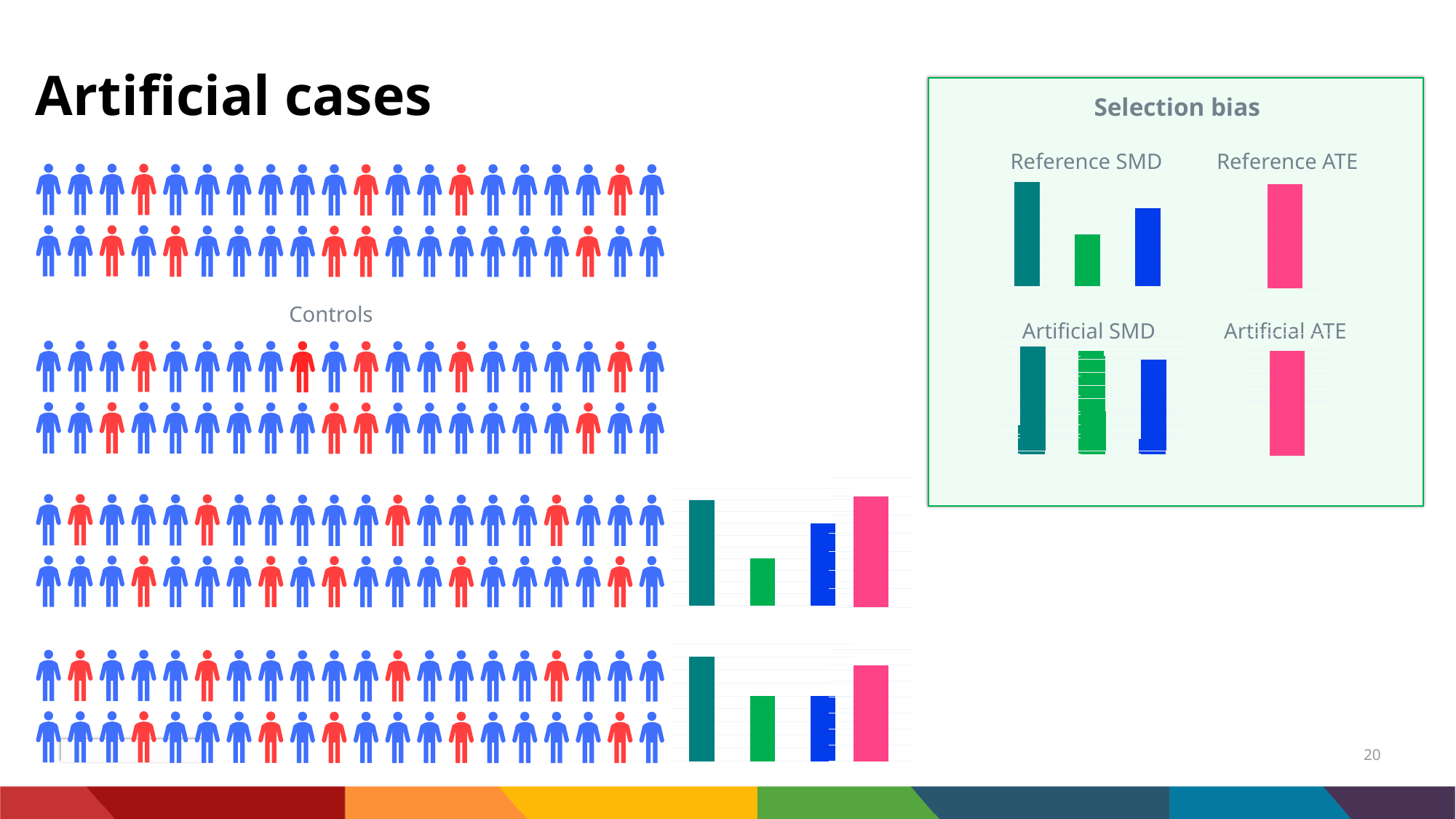
In the 'Selection bias' chart, how many bars are shown under 'Reference ATE'? 1 In the 'Selection bias' chart, is the teal bar under 'Reference SMD' taller or shorter than the green bar next to it? taller How many labelled groups (Reference SMD, Reference ATE, Artificial SMD, Artificial ATE) are in the 'Selection bias' chart? 4 In the 'Selection bias' chart, how many bars are shown under 'Reference SMD'? 3 In the small bar chart beside the third block of people icons (upper of the two charts at the bottom right), which bar is the shortest? the green bar What is the title of the boxed chart on the right of the slide? Selection bias What colour is the bar under 'Artificial ATE' in the 'Selection bias' chart? pink In the 'Selection bias' chart, which bar under 'Reference SMD' is the shortest? the green (middle) bar What kind of chart is shown inside the 'Selection bias' box? bar chart